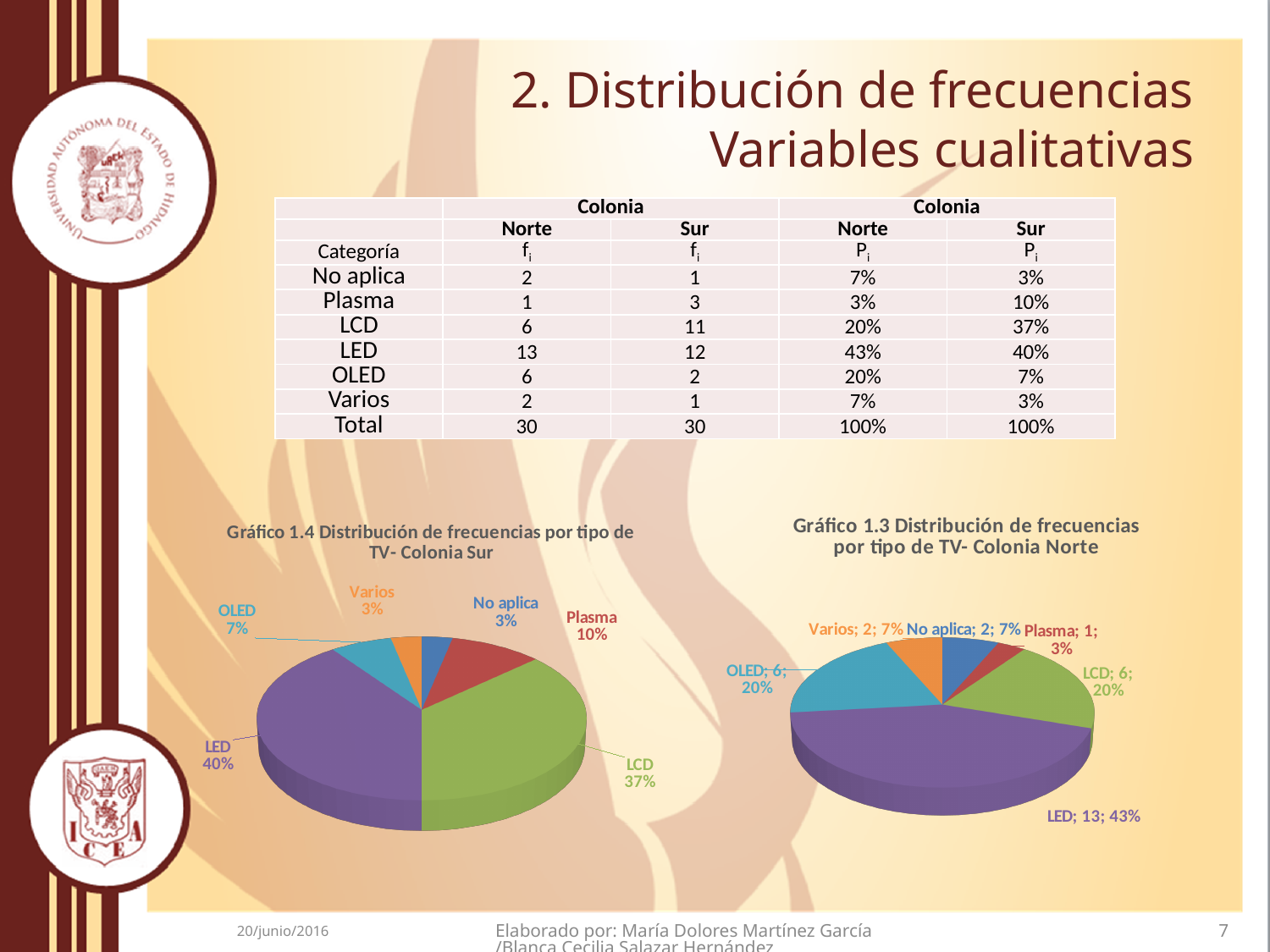
What is the title of the pie chart on the right of the slide? Gráfico 1.3 Distribución de frecuencias por tipo de TV- Colonia Norte In Gráfico 1.3 (Colonia Norte), which is larger, the slice for LCD or the slice for Varios? LCD In Gráfico 1.4 (Colonia Sur), what is the difference in percentage points between LED and OLED? 33 In Gráfico 1.4 (Colonia Sur), what share of the pie does LCD have? 37% In Gráfico 1.3 (Colonia Norte), what is the frequency value shown for LED? 13 In Gráfico 1.3 (Colonia Norte), what is the difference between the frequency values for LED and LCD? 7 In Gráfico 1.4 (Colonia Sur), how many slices does the pie have? 6 In Gráfico 1.3 (Colonia Norte), what share of the pie does OLED have? 20% What kind of chart is Gráfico 1.4 (Colonia Sur)? Pie chart In Gráfico 1.4 (Colonia Sur), which category has the largest slice? LED In Gráfico 1.4 (Colonia Sur), what share of the pie does Plasma have? 10% In Gráfico 1.3 (Colonia Norte), which category has the smallest slice? Plasma